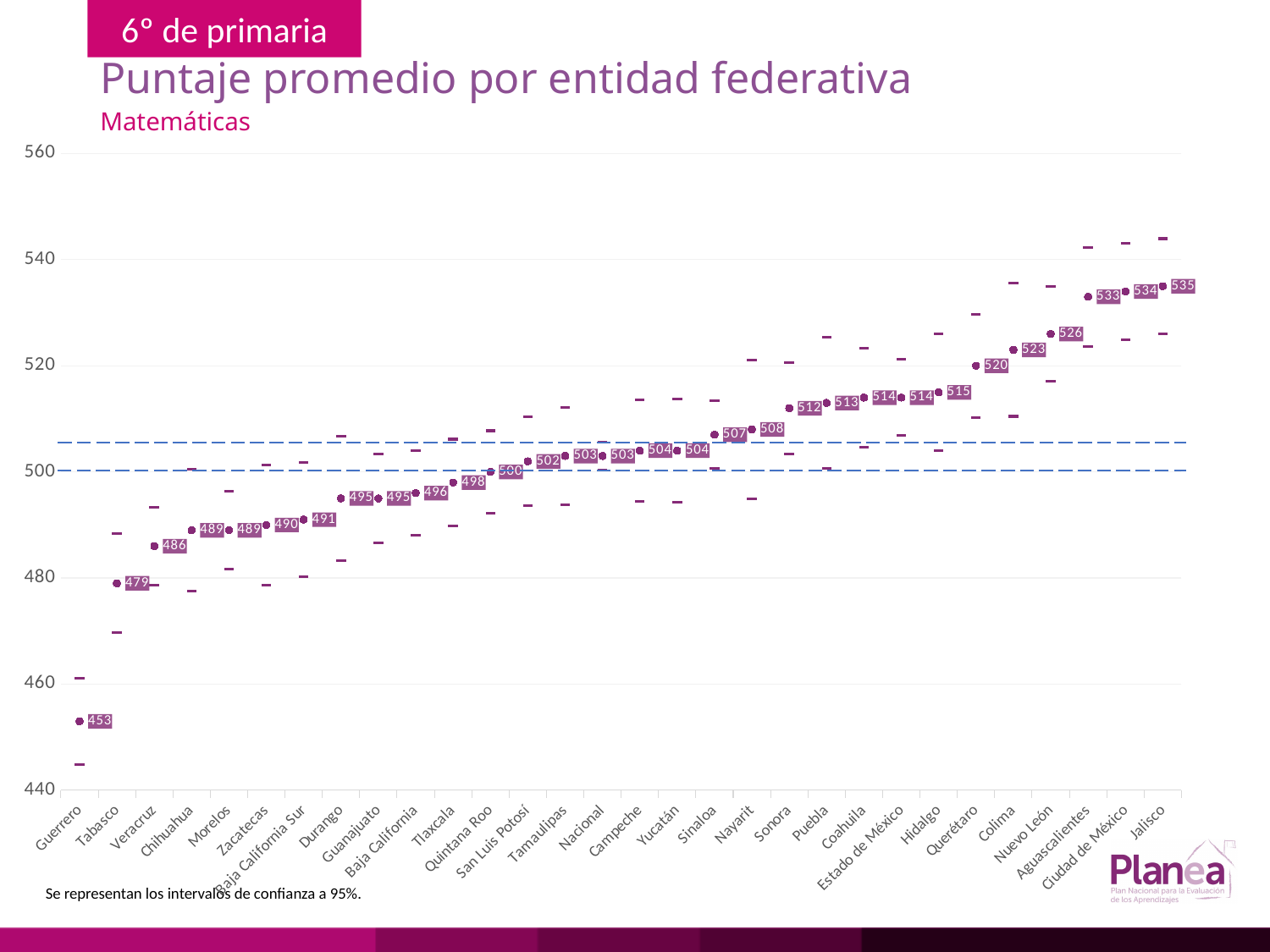
What subject is shown in the chart's subtitle? Matemáticas Which has a higher average score, Nuevo León or Colima? Nuevo León How many entities (categories) are plotted on the x axis? 30 Do the plotted values rise or fall from left to right along the x axis? rise What is the average score shown for Jalisco? 535 What is the average mathematics score for Guerrero? 453 Is the value for Tabasco greater or less than 480? less What is the value plotted for Nacional? 503 Which entity has the highest average score? Jalisco Which entity has the lowest average score? Guerrero What is the average score for Querétaro? 520 What is the difference between the scores of Jalisco and Guerrero? 82